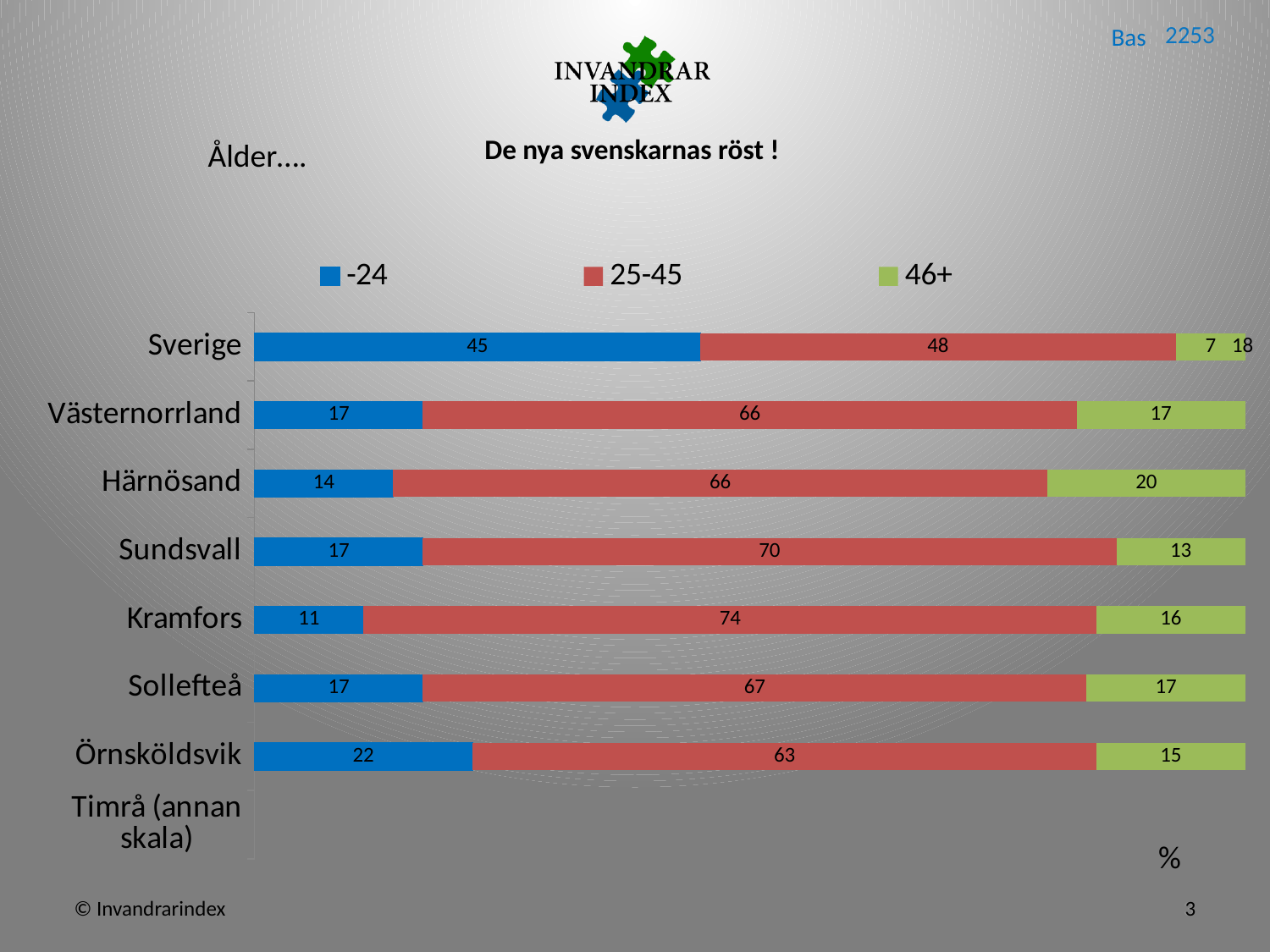
Which category has the highest value for the -24 series? Sverige What is the difference between the 25-45 values for Sundsvall and Örnsköldsvik? 7 Which is larger: the 46+ value for Härnösand or the 46+ value for Sundsvall? Härnösand What is the value for the 46+ series for Härnösand? 20 What kind of chart is shown on the slide? Stacked bar chart Which category has the highest value for the 25-45 series? Kramfors Which category has the lowest value for the -24 series? Kramfors How many series does the legend list? 3 What is the value for the 25-45 series for Kramfors? 74 What is the value for the -24 series for Örnsköldsvik? 22 What are the three legend entries of the chart? -24, 25-45, 46+ What is the total of the stacked bar for Västernorrland? 100